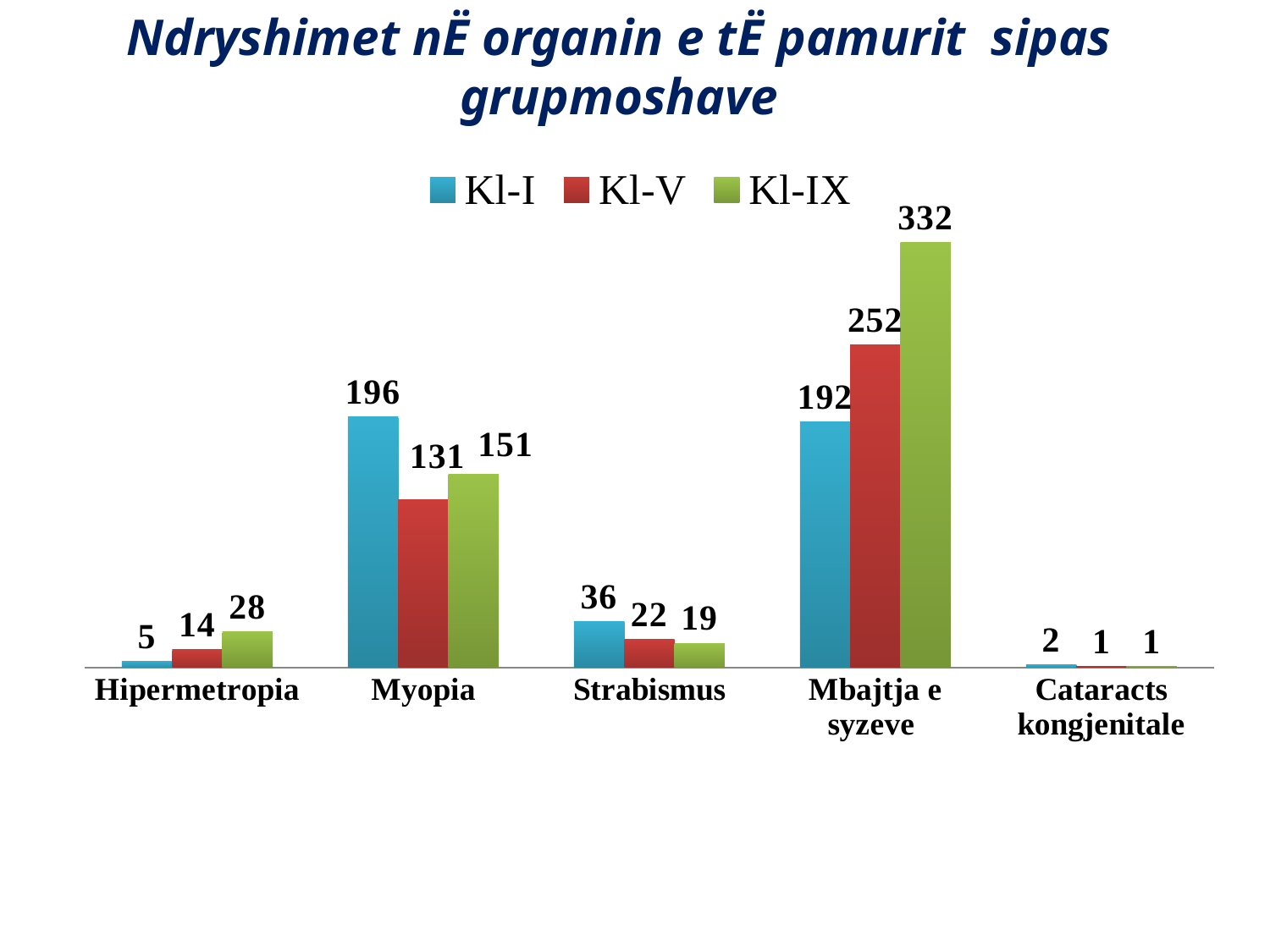
What is the Kl-IX value for Hipermetropia? 28 What kind of chart is shown on the slide? Bar chart How many series does the legend list? 3 What is the Kl-I value for Myopia? 196 What is the Kl-IX value for Mbajtja e syzeve? 332 How many categories are shown on the x axis? 5 Which is larger for Myopia: the Kl-V value or the Kl-IX value? Kl-IX What is the difference between the Kl-IX and Kl-I values for Mbajtja e syzeve? 140 What is the Kl-V value for Strabismus? 22 Which category has the lowest Kl-I value? Cataracts kongjenitale Which category has the highest Kl-V value? Mbajtja e syzeve What colour represents the Kl-V series? Red